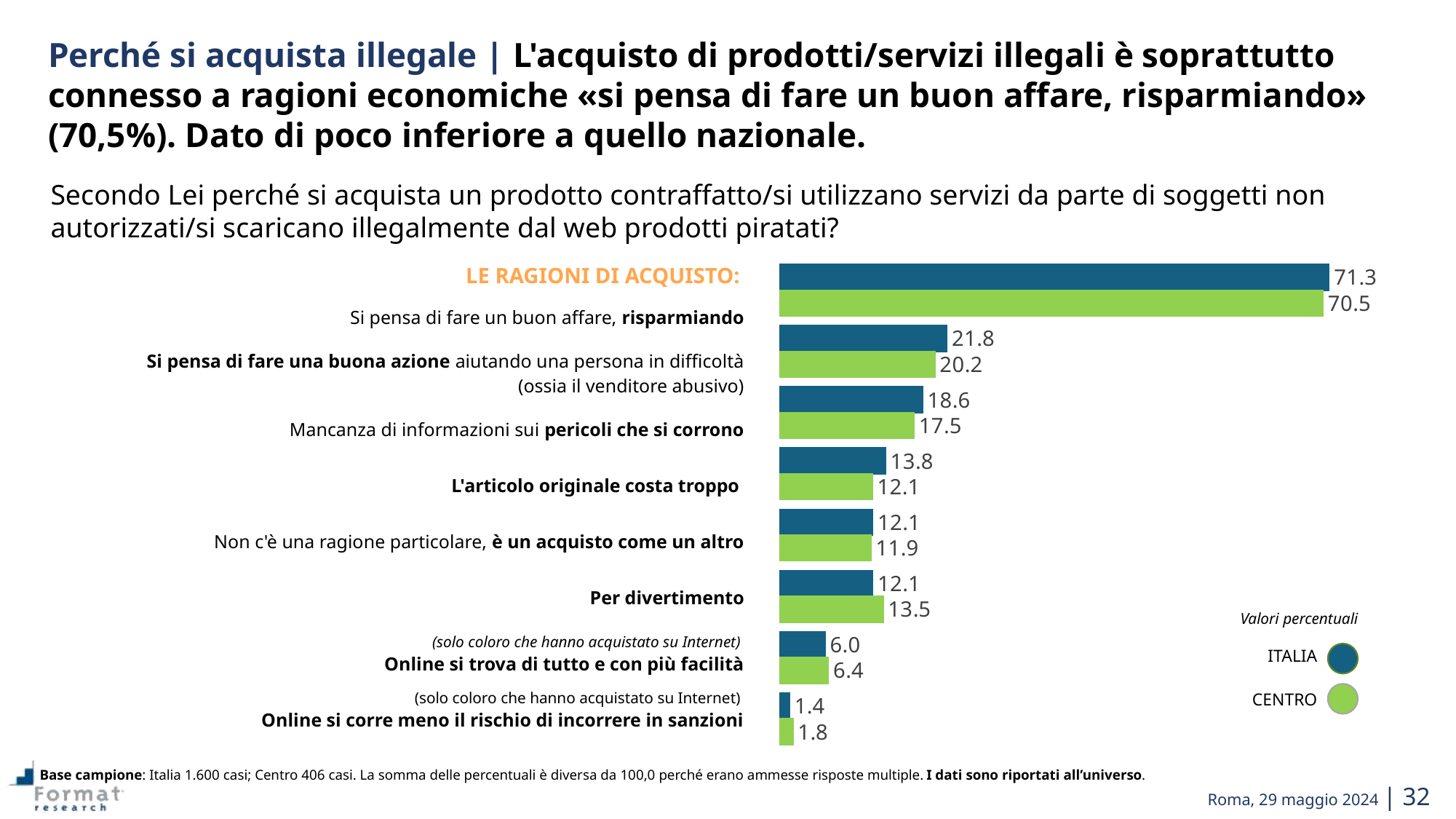
For "Si pensa di fare una buona azione aiutando una persona in difficoltà", which is larger: the ITALIA value or the CENTRO value? ITALIA Which reason has the highest ITALIA value? Si pensa di fare un buon affare, risparmiando What is the ITALIA value for "Mancanza di informazioni sui pericoli che si corrono"? 18.6 How many reasons (categories) are shown in the chart? 8 What is the difference between the ITALIA and CENTRO values for "Si pensa di fare un buon affare, risparmiando"? 0.8 What is the difference between the ITALIA and CENTRO values for "L'articolo originale costa troppo"? 1.7 What is the CENTRO value for "Si pensa di fare un buon affare, risparmiando"? 70.5 What is the CENTRO value for "Per divertimento"? 13.5 Which reason has the lowest CENTRO value? Online si corre meno il rischio di incorrere in sanzioni How many series does the legend list? 2 For "Per divertimento", which is larger: the ITALIA value or the CENTRO value? CENTRO What kind of chart is shown on the slide? Bar chart